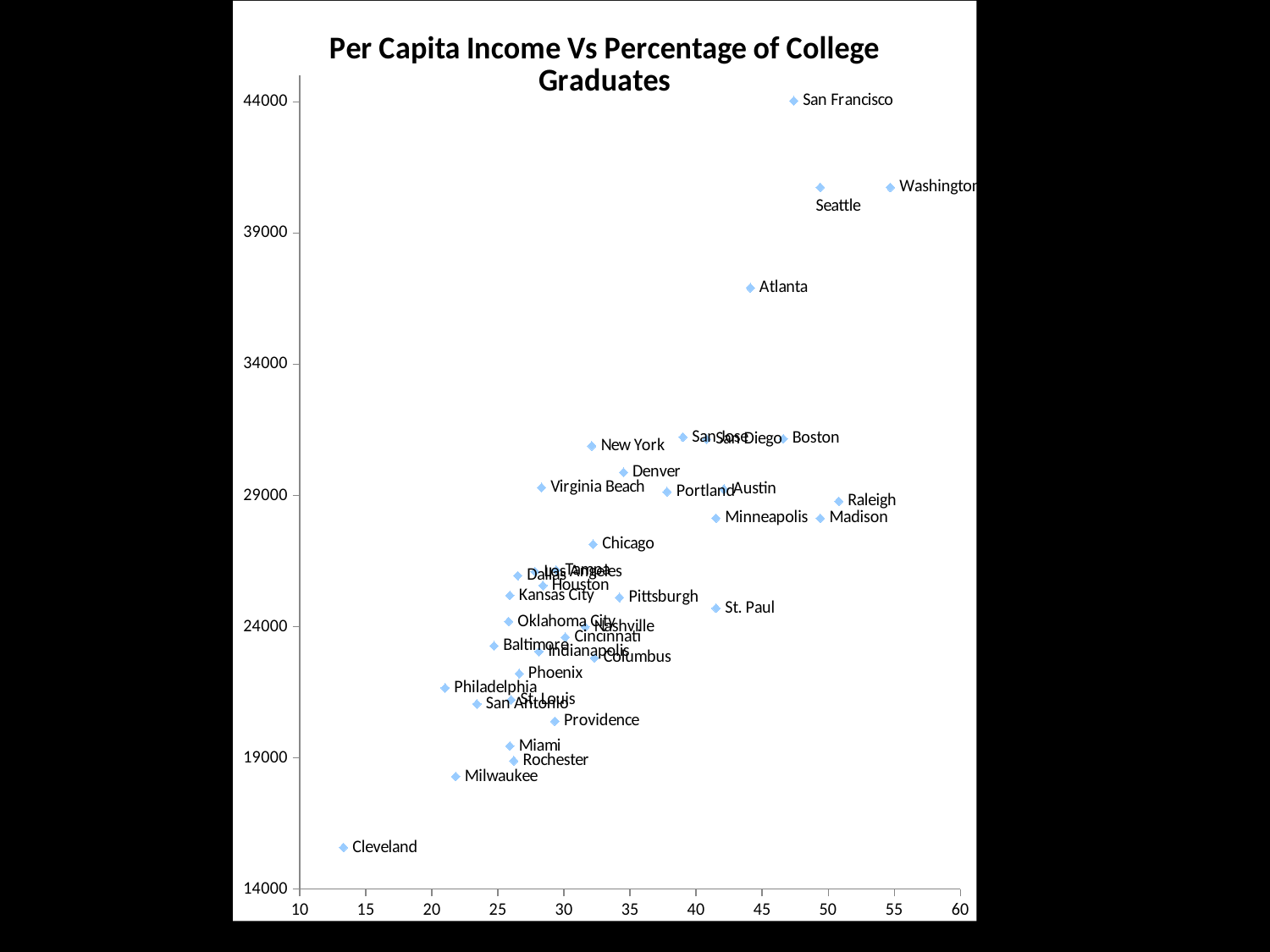
Is the per capita income for Atlanta greater or less than 34000? greater Overall, does per capita income tend to rise or fall as the percentage of college graduates increases? rise What kind of chart is shown on the slide? scatter chart Is the per capita income for Cleveland greater or less than 19000? less What is the title of the chart? Per Capita Income Vs Percentage of College Graduates Which city has the lowest per capita income on the chart? Cleveland Is the per capita income for Providence greater or less than 24000? less Which city has the highest per capita income on the chart? San Francisco Which city is plotted furthest to the left (lowest percentage of college graduates)? Cleveland Which city has the higher per capita income, Atlanta or Boston? Atlanta Which city is plotted furthest to the right (highest percentage of college graduates)? Washington